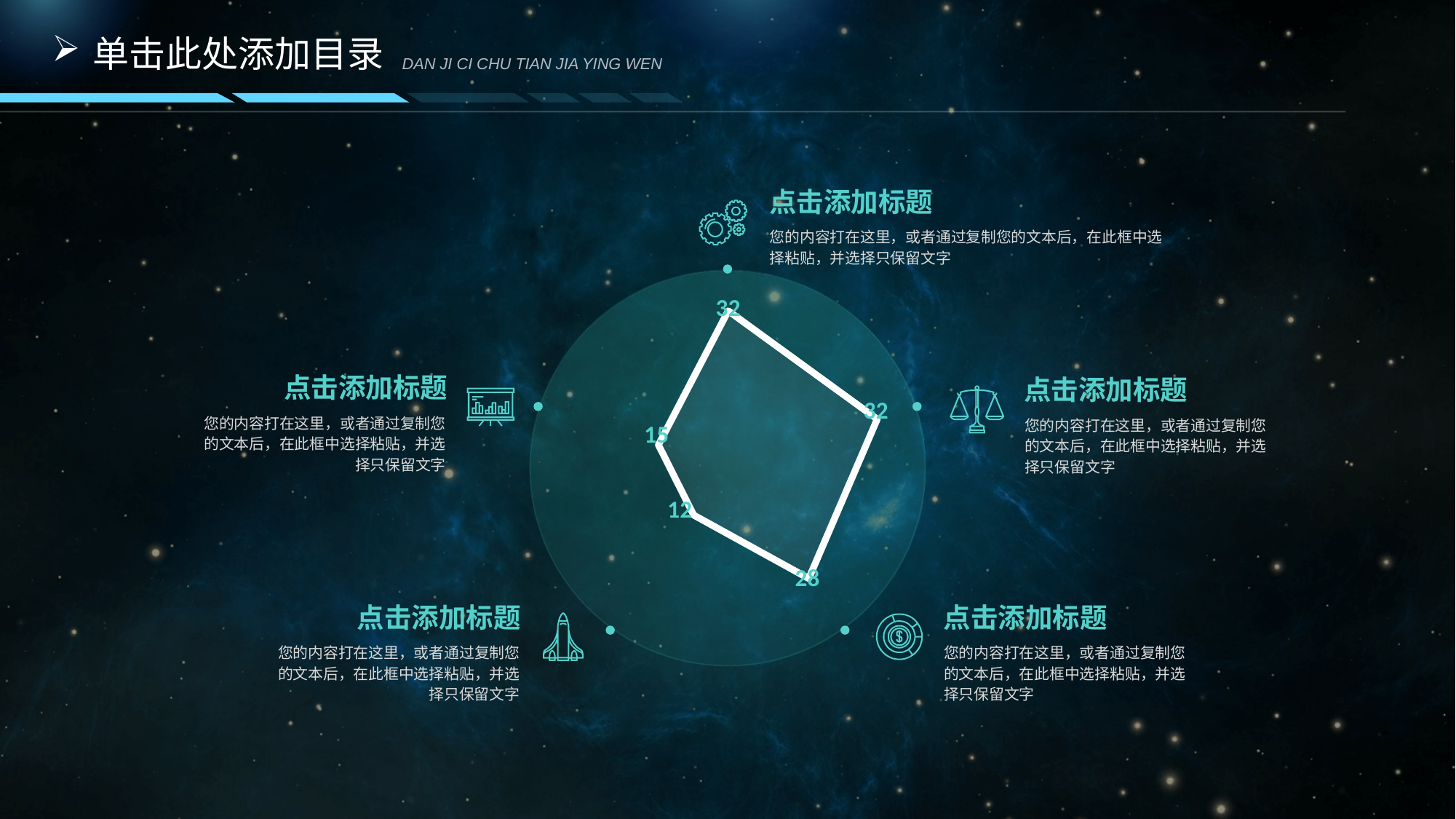
How many data points does the radar chart have? 5 What is the difference between the topmost point (32) and the lower-left point (12) on the radar chart? 20 What is the value of the lower-left point on the radar chart? 12 What kind of chart is shown in the centre of the slide? radar chart What is the highest value plotted on the radar chart? 32 Which is larger on the radar chart: the bottom point or the leftmost point? the bottom point What is the value of the topmost point on the radar chart? 32 What is the value of the rightmost point on the radar chart? 32 What is the value of the bottom point on the radar chart? 28 What colour is the data line of the radar chart? white What is the value of the leftmost point on the radar chart? 15 What is the lowest value plotted on the radar chart? 12